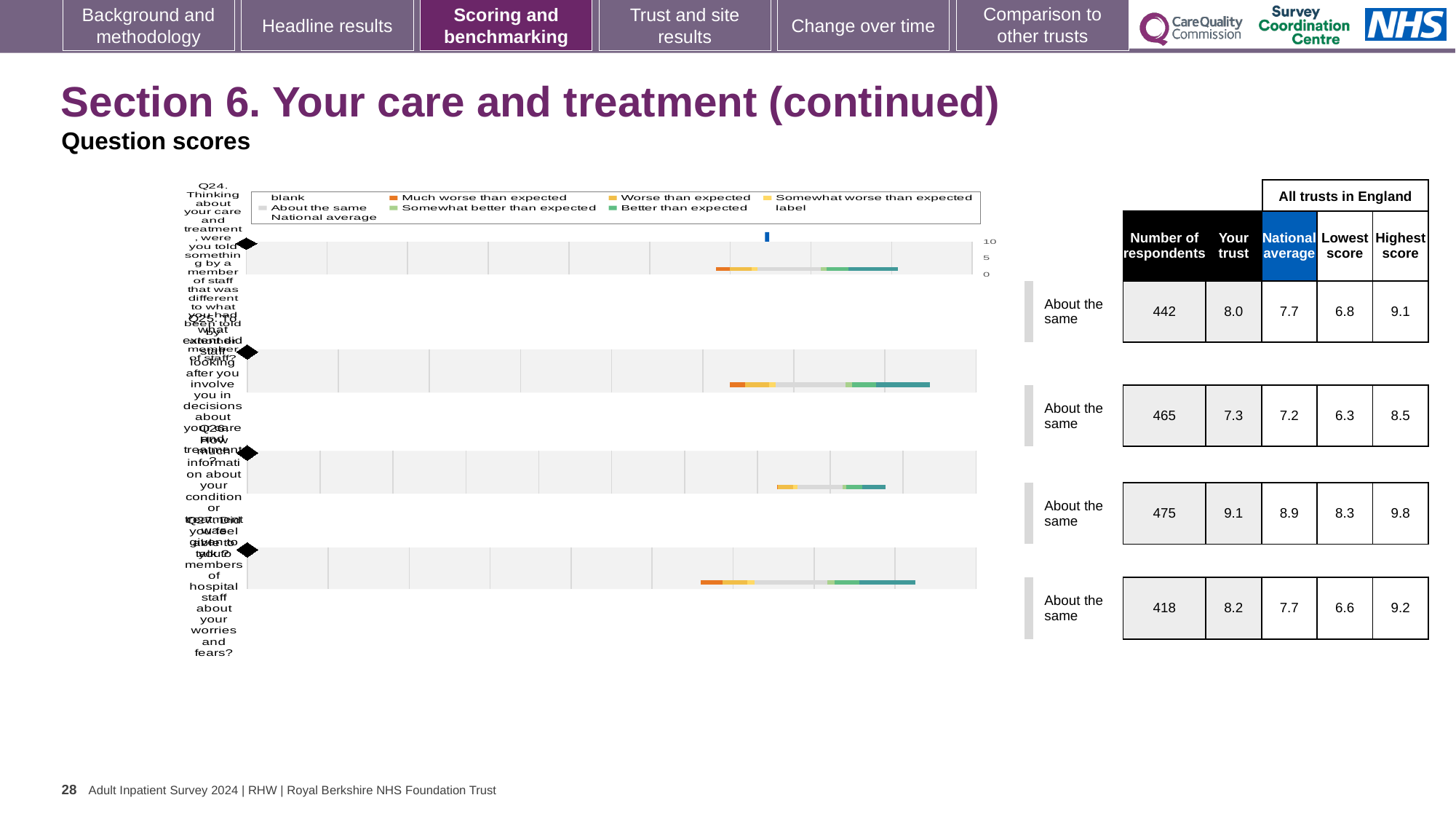
For the second chart (Q25), is the trust score larger or smaller than the national average? larger For the third chart (Q26), what is the highest score among all trusts in England? 9.8 What kind of chart is used for the four question-score charts on the slide? bar chart Which of the four charts has the highest 'Your trust' score? Q26 (third chart) For the fourth chart (Q27), what is the lowest score among all trusts in England? 6.6 Which of the four charts has the lowest 'Your trust' score? Q25 (second chart) For the top chart (Q24), what is the 'Your trust' score shown in the table? 8.0 For the second chart (Q25), what is the number of respondents? 465 How many question-score charts are shown on the slide? 4 For the top chart (Q24), what is the national average shown in the table? 7.7 For the fourth chart (Q27), what is the difference between the trust score and the national average? 0.5 What benchmark category is shown beside each of the four charts? About the same